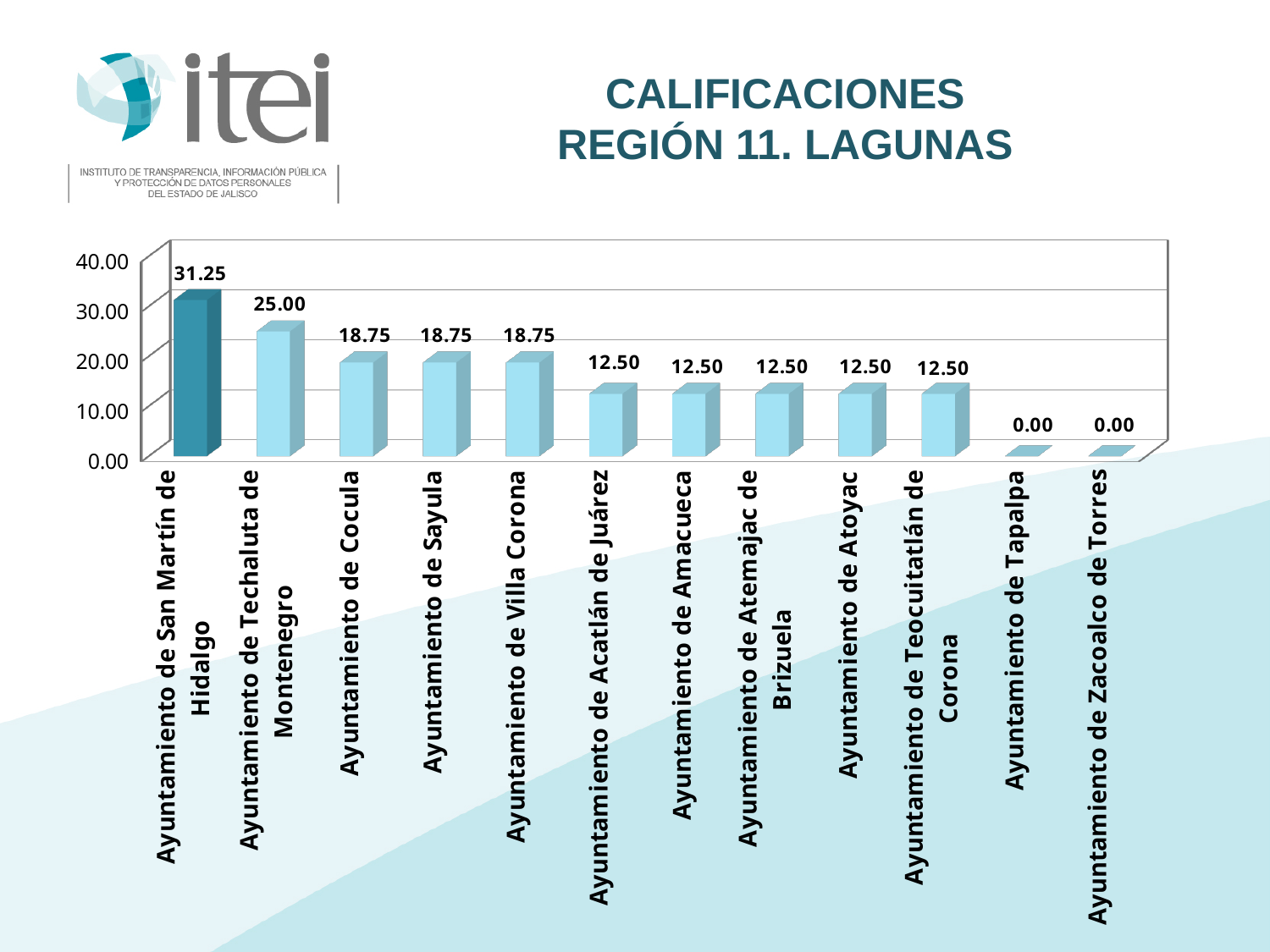
What is the value for Ayuntamiento de Acatlán de Juárez? 12.50 Which is larger, the value for Ayuntamiento de Sayula or the value for Ayuntamiento de Amacueca? Ayuntamiento de Sayula What is the value for Ayuntamiento de Tapalpa? 0.00 Is the value for Ayuntamiento de Techaluta de Montenegro greater or less than 20.00? greater Do the values rise or fall from left to right along the x axis? fall Which category has the highest value? Ayuntamiento de San Martín de Hidalgo How many categories are shown on the x axis? 12 What is the value for Ayuntamiento de San Martín de Hidalgo? 31.25 What kind of chart is shown on the slide? bar chart What is the difference between the values for Ayuntamiento de Cocula and Ayuntamiento de Atoyac? 6.25 What is the value for Ayuntamiento de Techaluta de Montenegro? 25.00 What is the difference between the values for Ayuntamiento de San Martín de Hidalgo and Ayuntamiento de Techaluta de Montenegro? 6.25